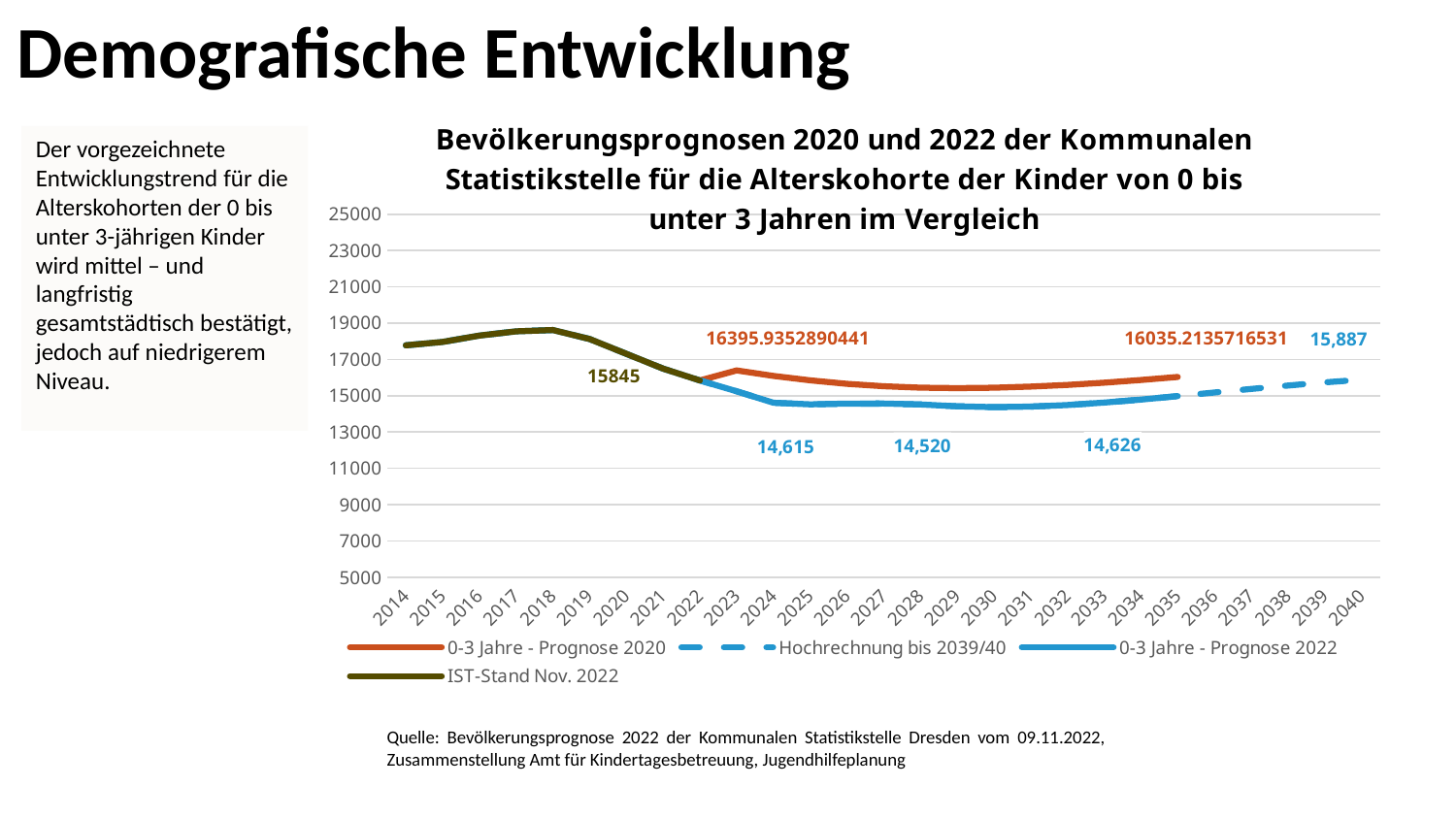
Is the value of the 'IST-Stand Nov. 2022' line in 2018 greater or less than 17000? greater In 2030, which line is higher: '0-3 Jahre - Prognose 2020' or '0-3 Jahre - Prognose 2022'? 0-3 Jahre - Prognose 2020 Does the 'IST-Stand Nov. 2022' line rise or fall between 2018 and 2022? fall What value is labelled on the '0-3 Jahre - Prognose 2020' line at 2023? 16395.9352890441 What is the difference between the labelled value 15,887 on the 'Hochrechnung bis 2039/40' line and the labelled value 14,615 on the '0-3 Jahre - Prognose 2022' line? 1,272 Is the value of the '0-3 Jahre - Prognose 2022' line in 2030 greater or less than 15000? less What type of chart is shown on the slide? line chart Which of the three labelled values on the '0-3 Jahre - Prognose 2022' line is the lowest? 14,520 What value is labelled at the end of the dashed 'Hochrechnung bis 2039/40' line in 2040? 15,887 How many series does the chart legend list? 4 What value is labelled on the '0-3 Jahre - Prognose 2020' line at 2035? 16035.2135716531 What value is labelled on the 'IST-Stand Nov. 2022' line at 2022? 15845